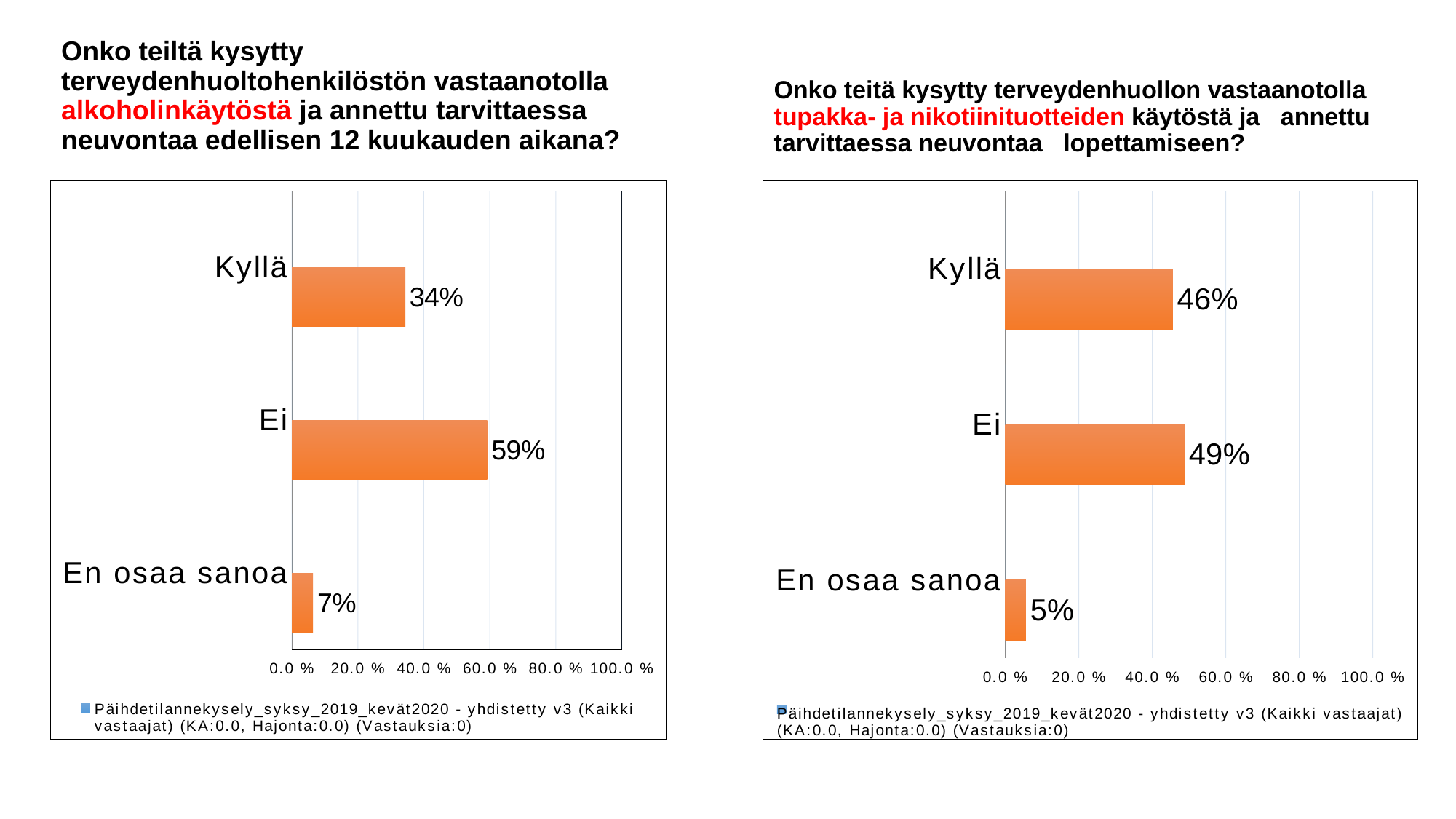
What kind of chart is the left chart (alcohol use question)? Bar chart In the left chart (alcohol use question), what is the difference between the values for Ei and Kyllä? 25% In the right chart (tobacco and nicotine products question), what is the value for En osaa sanoa? 5% In the left chart (alcohol use question), which category has the highest value? Ei In the right chart (tobacco and nicotine products question), what is the difference between the values for Ei and Kyllä? 3% In the left chart (alcohol use question), what is the value for Ei? 59% Is the value for Kyllä larger in the left chart or the right chart? Right chart In the right chart (tobacco and nicotine products question), what is the value for Kyllä? 46% In the left chart (alcohol use question), what is the value for En osaa sanoa? 7% In the right chart (tobacco and nicotine products question), which category has the lowest value? En osaa sanoa How many categories does the right chart (tobacco and nicotine products question) show? 3 In the left chart (alcohol use question), what is the value for Kyllä? 34%